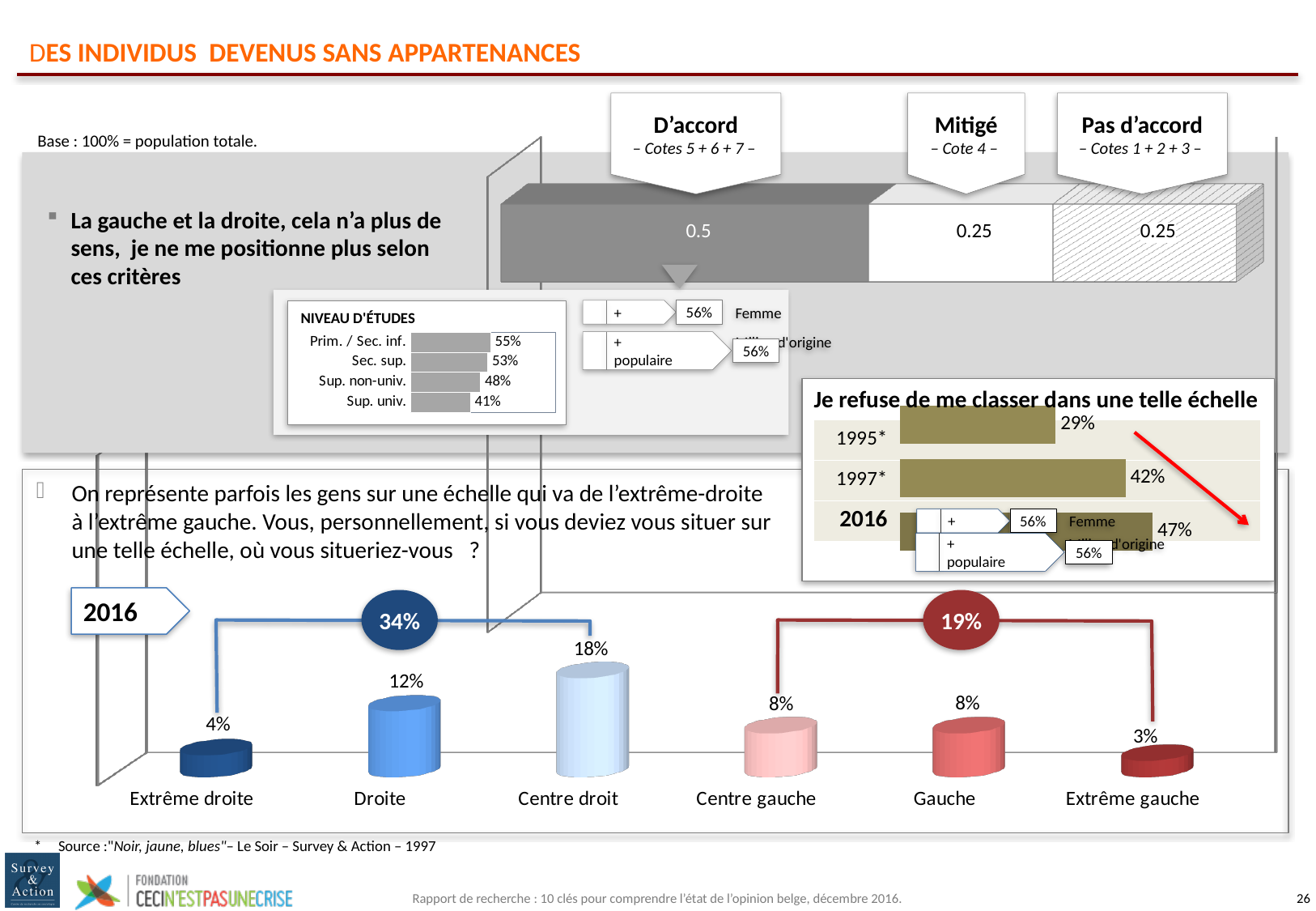
In the bottom chart of political self-positioning, how many categories are shown on the x axis? 6 In the 'Niveau d'études' chart, which category has the highest value? Prim. / Sec. inf. In the chart titled 'Je refuse de me classer dans une telle échelle', what is the difference between 1997* and 1995*? 13% In the top stacked bar, what is the value for the 'D'accord' segment? 0.5 In the bottom chart of political self-positioning, what is the value for Centre droit? 18% In the bottom chart of political self-positioning, what is the difference between Droite and Extrême droite? 8% In the chart titled 'Je refuse de me classer dans une telle échelle', do the values rise or fall from 1995 to 2016? rise In the bottom chart of political self-positioning, which category has the lowest value? Extrême gauche In the bottom chart of political self-positioning, which category has the highest value? Centre droit In the 'Niveau d'études' chart, what is the value for Sup. univ.? 41% In the chart titled 'Je refuse de me classer dans une telle échelle', what is the value for 2016? 47% In the bottom chart of political self-positioning, what is the value for Extrême gauche? 3%